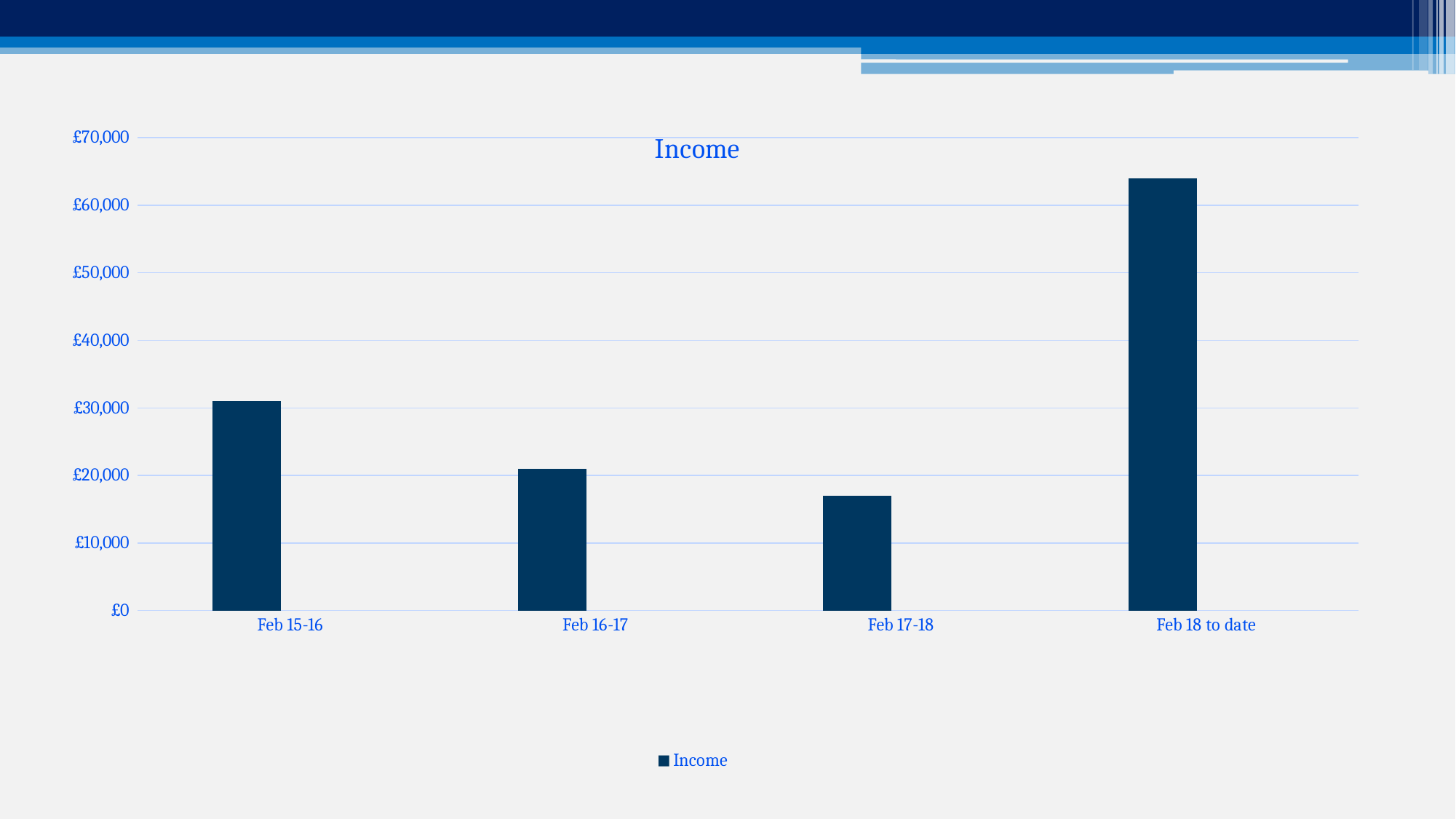
Is the income for Feb 17-18 greater or less than £20,000? less Do the income values rise or fall from Feb 15-16 to Feb 17-18? fall How many series does the legend of the Income chart list? 1 What kind of chart is shown on the slide? bar chart What is the title of the chart? Income Is the income for Feb 16-17 greater or less than £30,000? less Which category has the lowest income? Feb 17-18 Which is larger, the income for Feb 15-16 or for Feb 16-17? Feb 15-16 Is the income for Feb 18 to date greater or less than £60,000? greater How many categories are shown on the x axis of the Income chart? 4 Which category has the highest income? Feb 18 to date